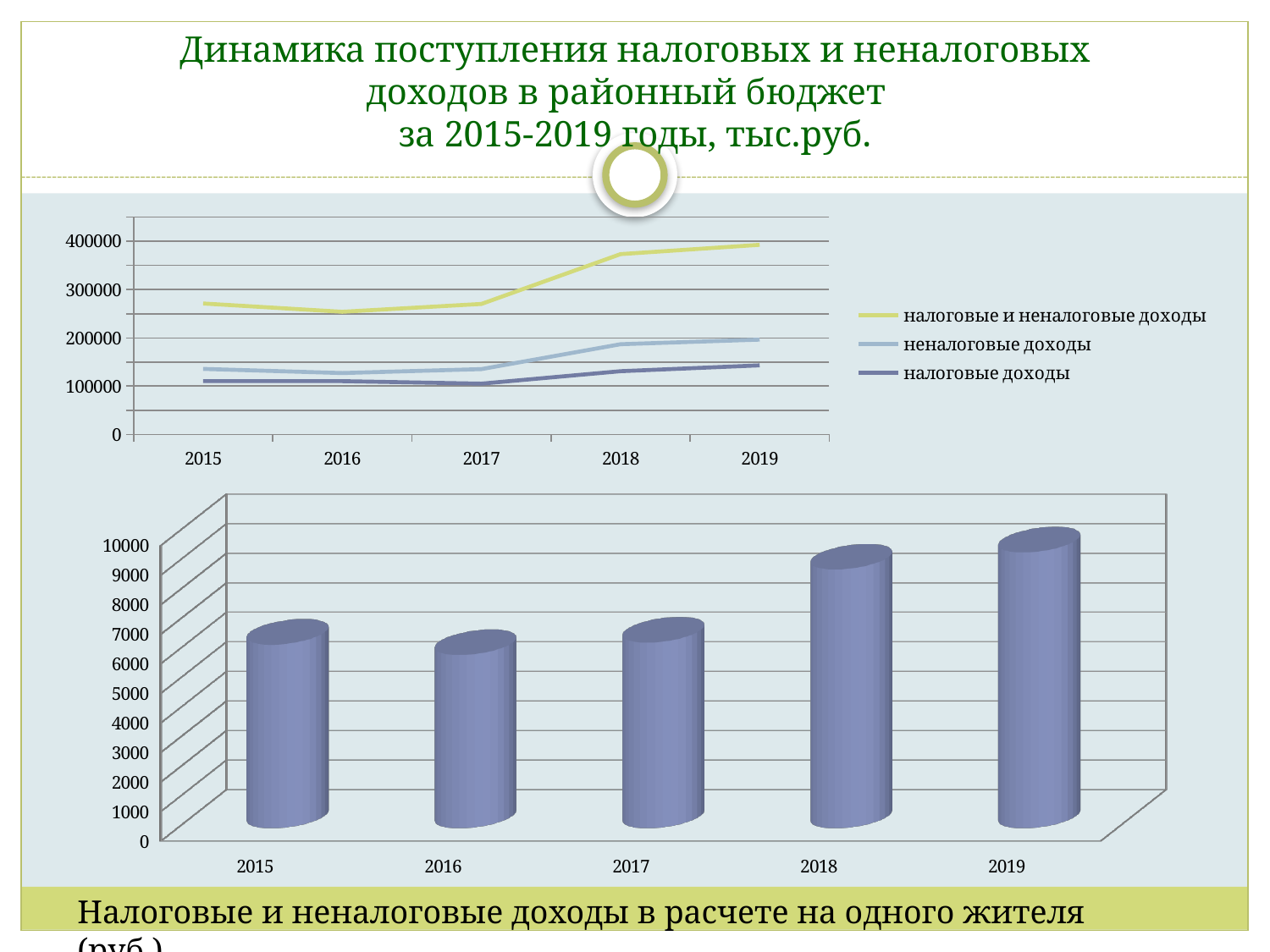
What kind of chart is the top chart on the slide? line chart How many years are shown on the x axis of the bottom chart? 5 In the top chart, which series has the highest values across all years? налоговые и неналоговые доходы In the bottom chart, which year has the lowest bar? 2016 What kind of chart is the bottom chart on the slide? bar chart How many series does the legend of the top chart list? 3 In the bottom chart, is the value for 2018 greater or less than 8000? greater In the top chart, does the line for 'налоговые и неналоговые доходы' rise or fall from 2017 to 2019? rise In the bottom chart, which year has the highest bar? 2019 In the bottom chart, is the value for 2016 greater or less than 7000? less In the top chart, is the value of 'налоговые доходы' for 2017 greater or less than 200000? less